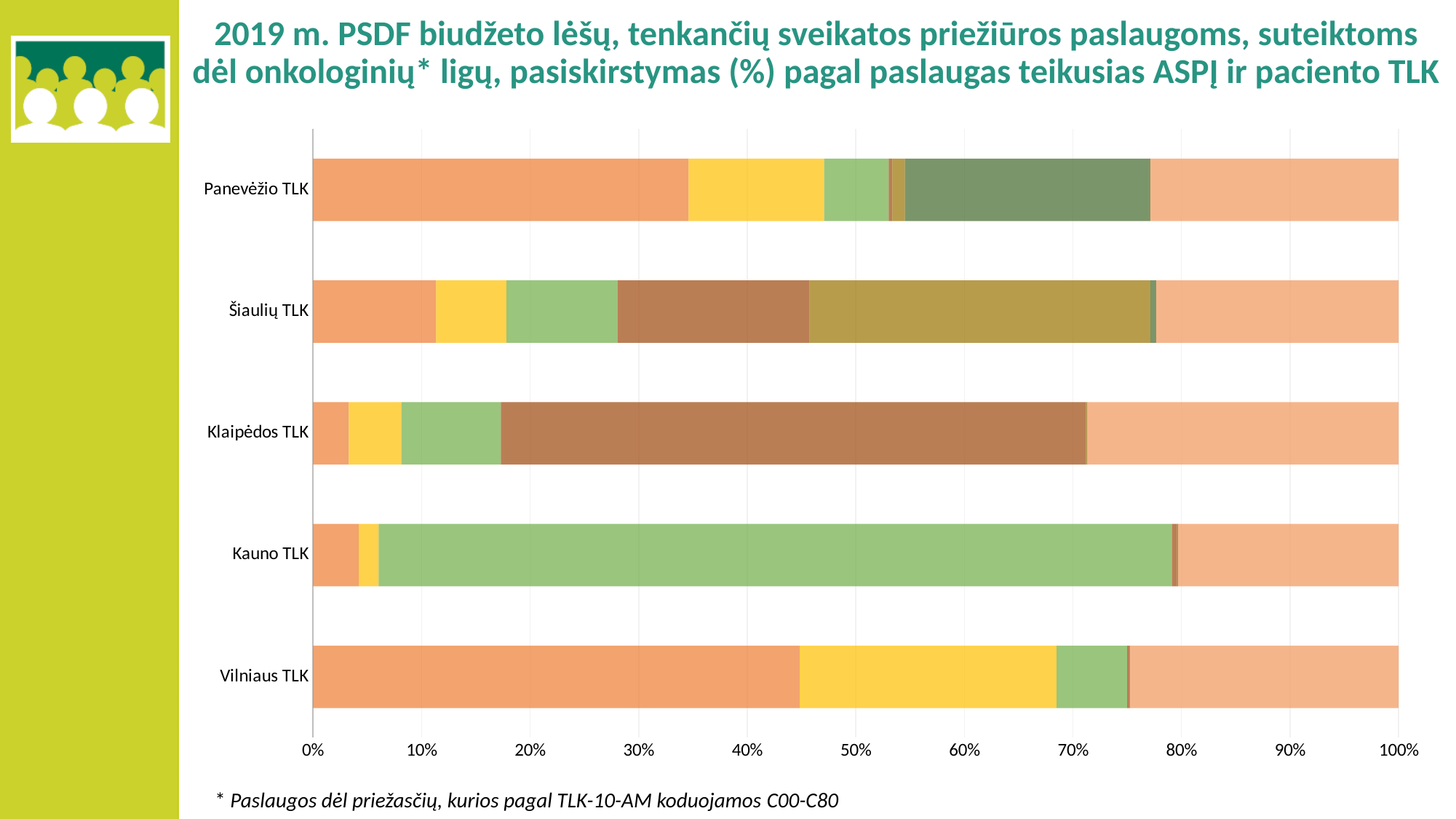
Is the leftmost (orange) segment of the Vilniaus TLK bar greater or less than 40%? greater Does the large light-green segment of the Kauno TLK bar end at a value greater or less than 70%? greater Is the leftmost (orange) segment of the Panevėžio TLK bar greater or less than 30%? greater What is the interval between tick marks on the horizontal axis? 10% Which TLK bar has the largest leftmost (orange) segment? Vilniaus TLK What is the total length of each stacked bar on the chart? 100% How many TLK categories are plotted on the chart? 5 Which TLK category is listed at the bottom of the chart? Vilniaus TLK What kind of chart is shown on the slide? Stacked horizontal bar chart Which TLK category is listed at the top of the chart? Panevėžio TLK What is the maximum value shown on the horizontal axis? 100%